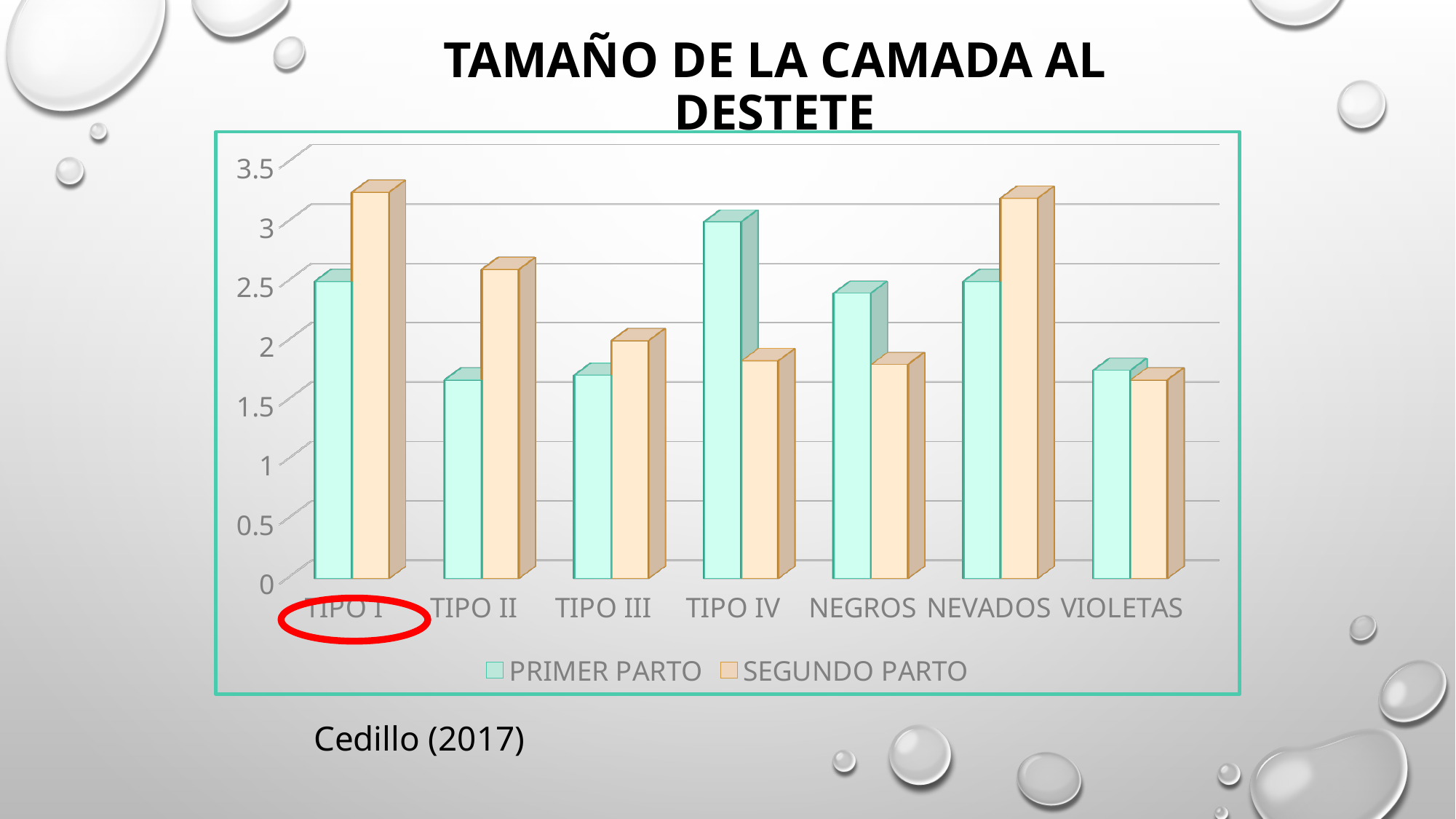
For TIPO I, which is larger: PRIMER PARTO or SEGUNDO PARTO? SEGUNDO PARTO What kind of chart is shown on the slide? bar chart Which category has the highest PRIMER PARTO value? TIPO IV For TIPO IV, which is larger: PRIMER PARTO or SEGUNDO PARTO? PRIMER PARTO What is the title of the chart on the slide? TAMAÑO DE LA CAMADA AL DESTETE How many categories are shown on the x axis of the chart? 7 For NEGROS, which is larger: PRIMER PARTO or SEGUNDO PARTO? PRIMER PARTO Is the PRIMER PARTO value for TIPO II greater or less than 2? less Is the SEGUNDO PARTO value for TIPO I greater or less than 3? greater Which category label on the x axis is circled in red? TIPO I How many series does the chart's legend list? 2 Is the PRIMER PARTO value for TIPO IV greater or less than 2.5? greater